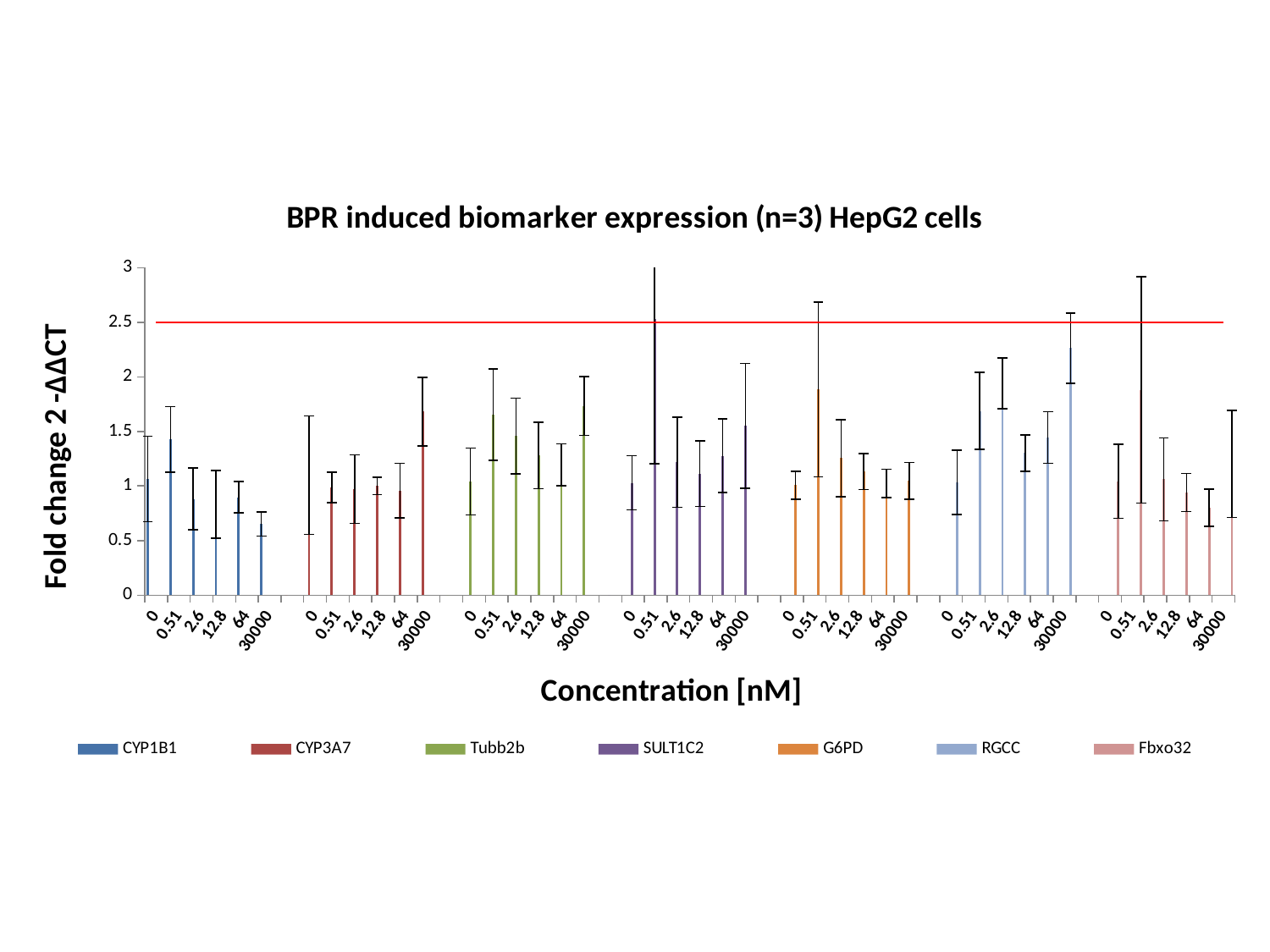
Is the value for CYP1B1 at 30000 nM greater or less than 1? less Is the value for RGCC at 2.6 nM greater or less than 1.5? greater Is the value for CYP1B1 at 0.51 nM greater or less than 1? greater What kind of chart is shown on the slide? bar chart What is the title of the chart? BPR induced biomarker expression (n=3) HepG2 cells How many concentration levels are plotted for each biomarker series? 6 How many series does the legend list? 7 What is the label of the x axis? Concentration [nM]